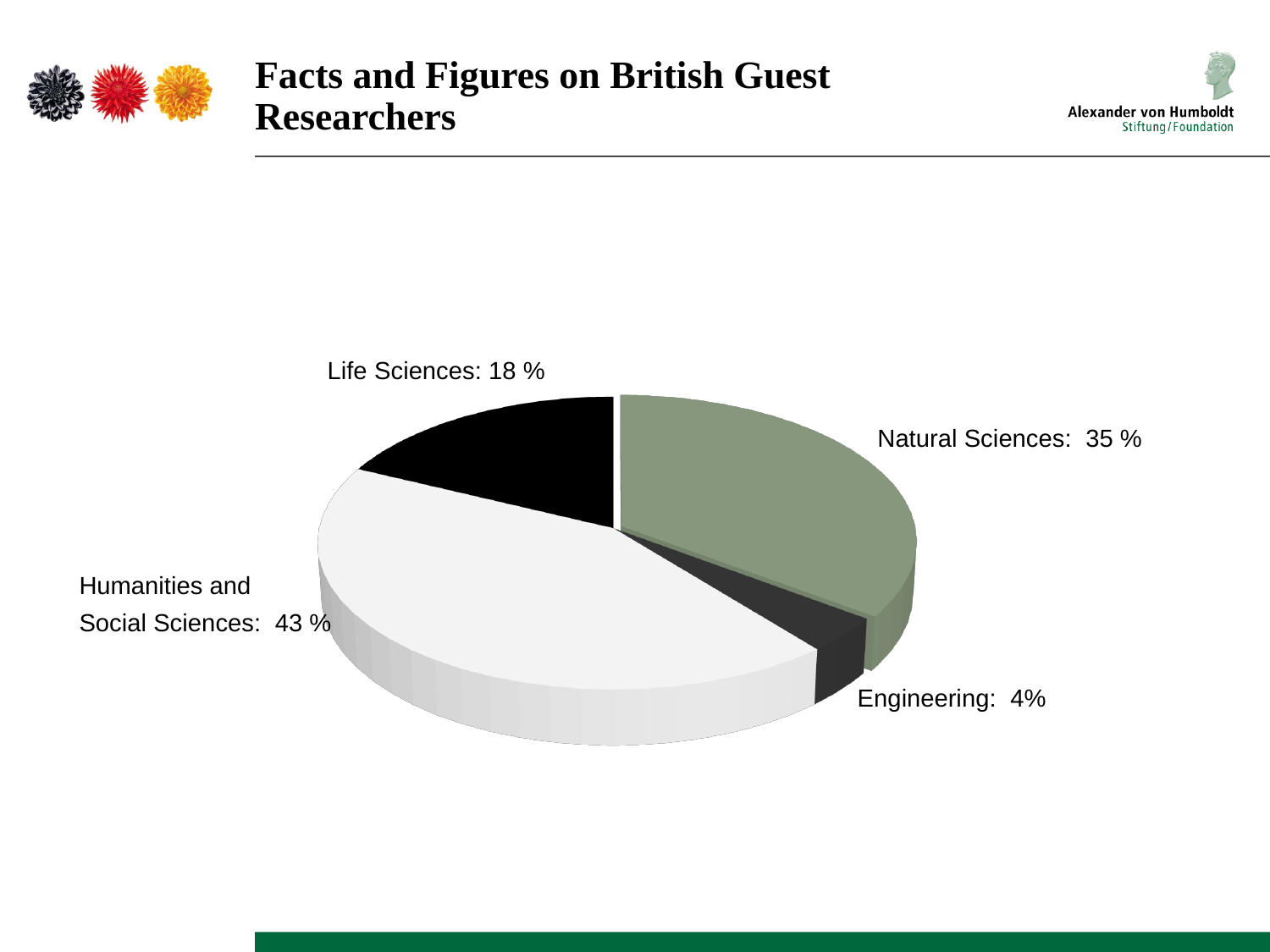
What is the title of the slide containing the chart? Facts and Figures on British Guest Researchers How many fields are shown in the pie chart? 4 How many percentage points larger is the Humanities and Social Sciences share than the Natural Sciences share? 8 What share of British guest researchers is in Engineering? 4% How many percentage points larger is the Life Sciences share than the Engineering share? 14 Which has a larger share, Natural Sciences or Life Sciences? Natural Sciences Which field has the largest share of British guest researchers? Humanities and Social Sciences Which field has the smallest share of British guest researchers? Engineering What kind of chart is shown on the slide? Pie chart What share of British guest researchers is in Humanities and Social Sciences? 43 % What share of British guest researchers is in Natural Sciences? 35 % What share of British guest researchers is in Life Sciences? 18 %